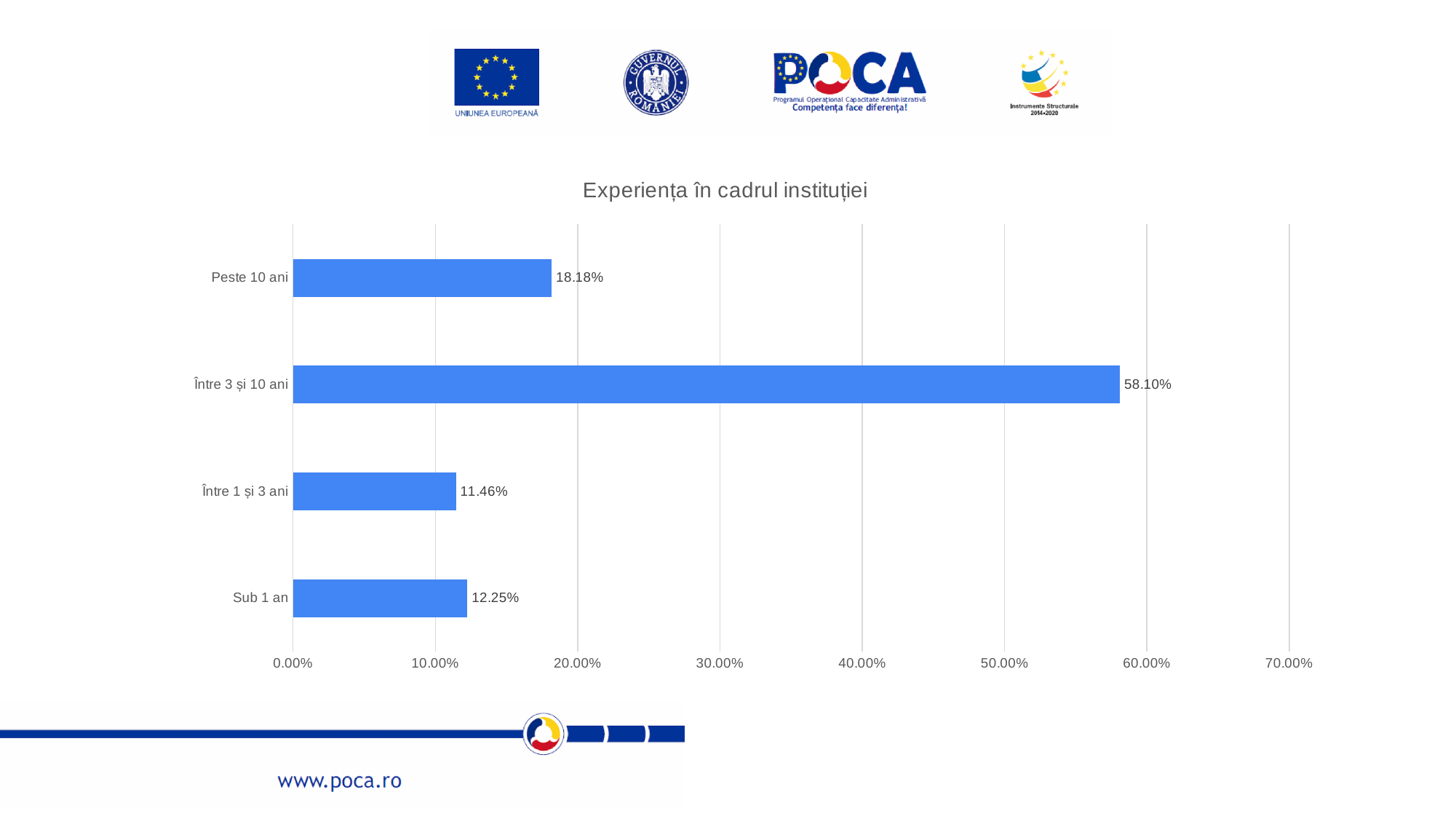
What is the value for "Peste 10 ani"? 18.18% Which category has the highest value? Între 3 și 10 ani Is the value for "Între 3 și 10 ani" greater or less than 50.00%? greater How many categories are shown in the chart? 4 What is the value for "Între 1 și 3 ani"? 11.46% Which category has the lowest value? Între 1 și 3 ani What is the value for "Sub 1 an"? 12.25% What is the title of the chart? Experiența în cadrul instituției What is the difference between the values for "Între 3 și 10 ani" and "Peste 10 ani"? 39.92% What kind of chart is shown on the slide? Bar chart What is the value for "Între 3 și 10 ani"? 58.10% Which is larger, the value for "Peste 10 ani" or the value for "Sub 1 an"? Peste 10 ani